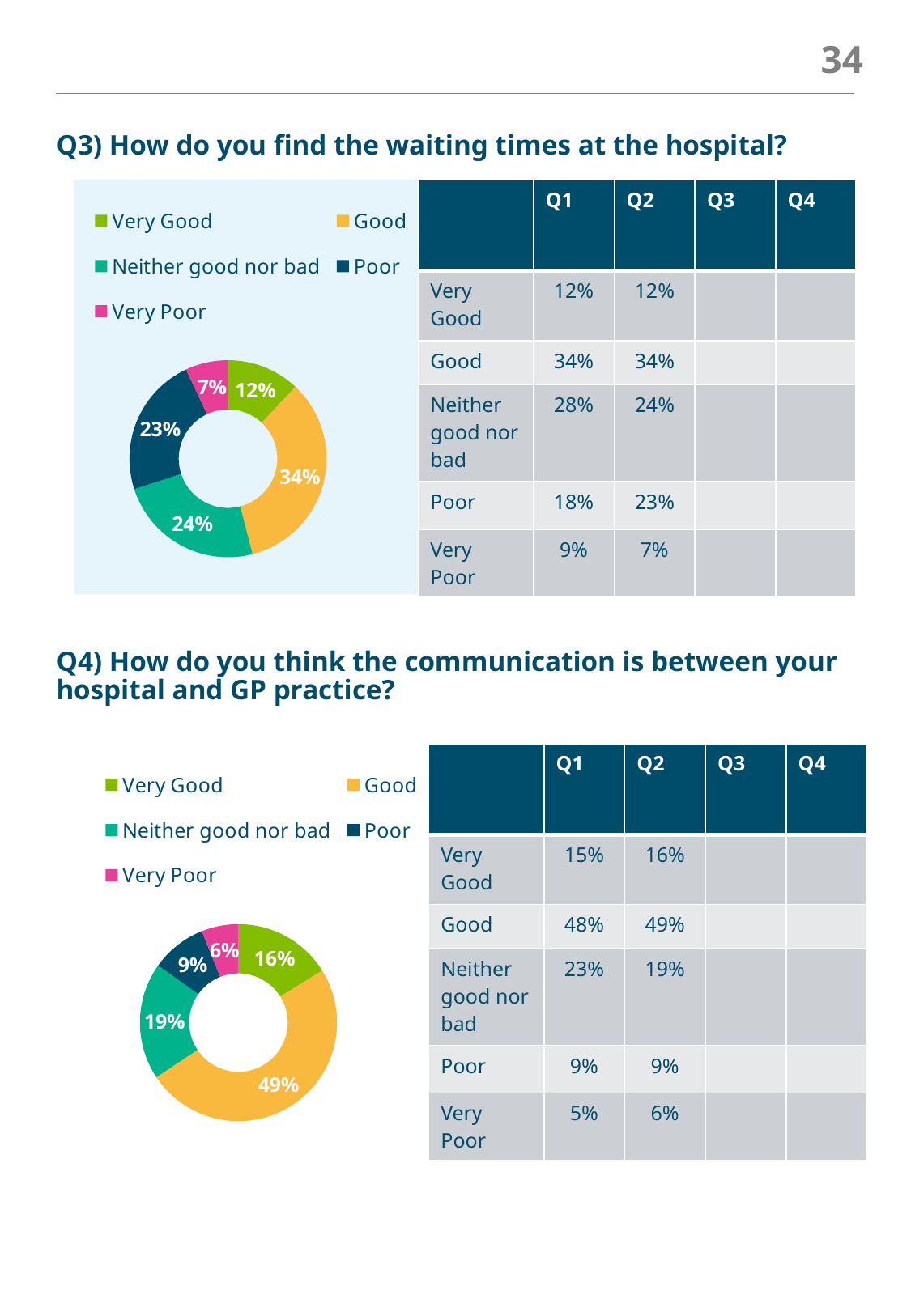
In the Q3 waiting times chart, what is the difference between Good and Very Good? 22% In the Q3 waiting times chart, which category has the smallest slice? Very Poor In the Q3 waiting times chart, what colour is the Very Poor slice? Pink What kind of chart is used for the Q4 communication question? Doughnut (pie) chart In the Q4 communication chart, what is the value for Neither good nor bad? 19% In the Q4 communication chart, which is larger, Very Good or Poor? Very Good In the Q3 waiting times chart, what is the value for Good? 34% In the Q3 waiting times chart, how many categories does the legend list? 5 In the Q4 communication chart, what is the value for Good? 49% In the Q3 waiting times chart, what is the value for Poor? 23% In the Q3 waiting times chart, which category has the largest slice? Good In the Q4 communication chart, what is the difference between Good and Neither good nor bad? 30%